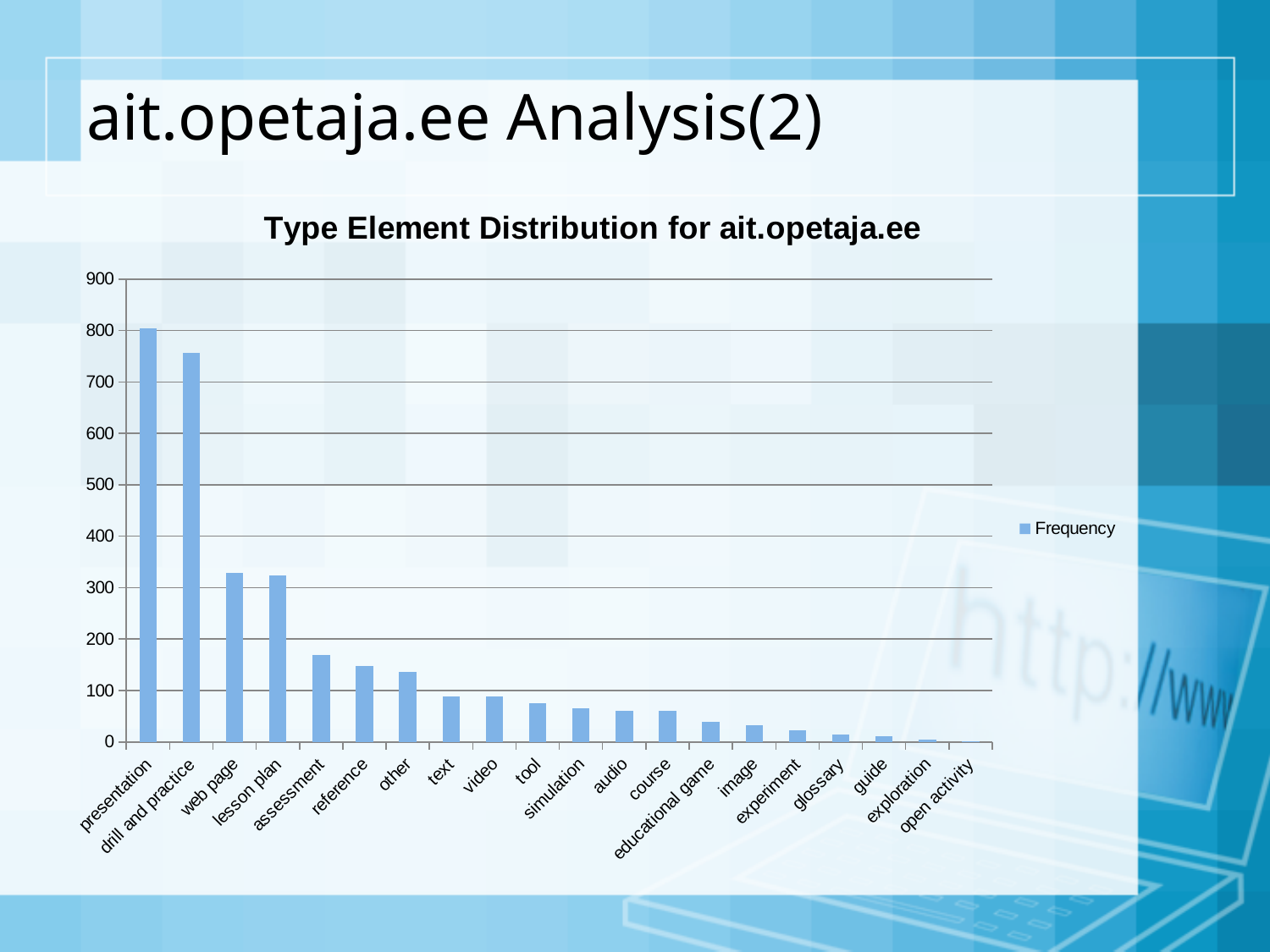
What is the name of the series shown in the legend? Frequency What is the title of the chart? Type Element Distribution for ait.opetaja.ee Is the value for assessment greater or less than 200? less How many categories are shown on the x axis? 20 Which category has the highest frequency? presentation How many series does the legend list? 1 Which is larger, the value for presentation or the value for drill and practice? presentation Is the value for web page greater or less than 300? greater What kind of chart is shown on the slide? bar chart Do the values generally rise or fall moving from left to right along the x axis? fall Is the value for drill and practice greater or less than 700? greater